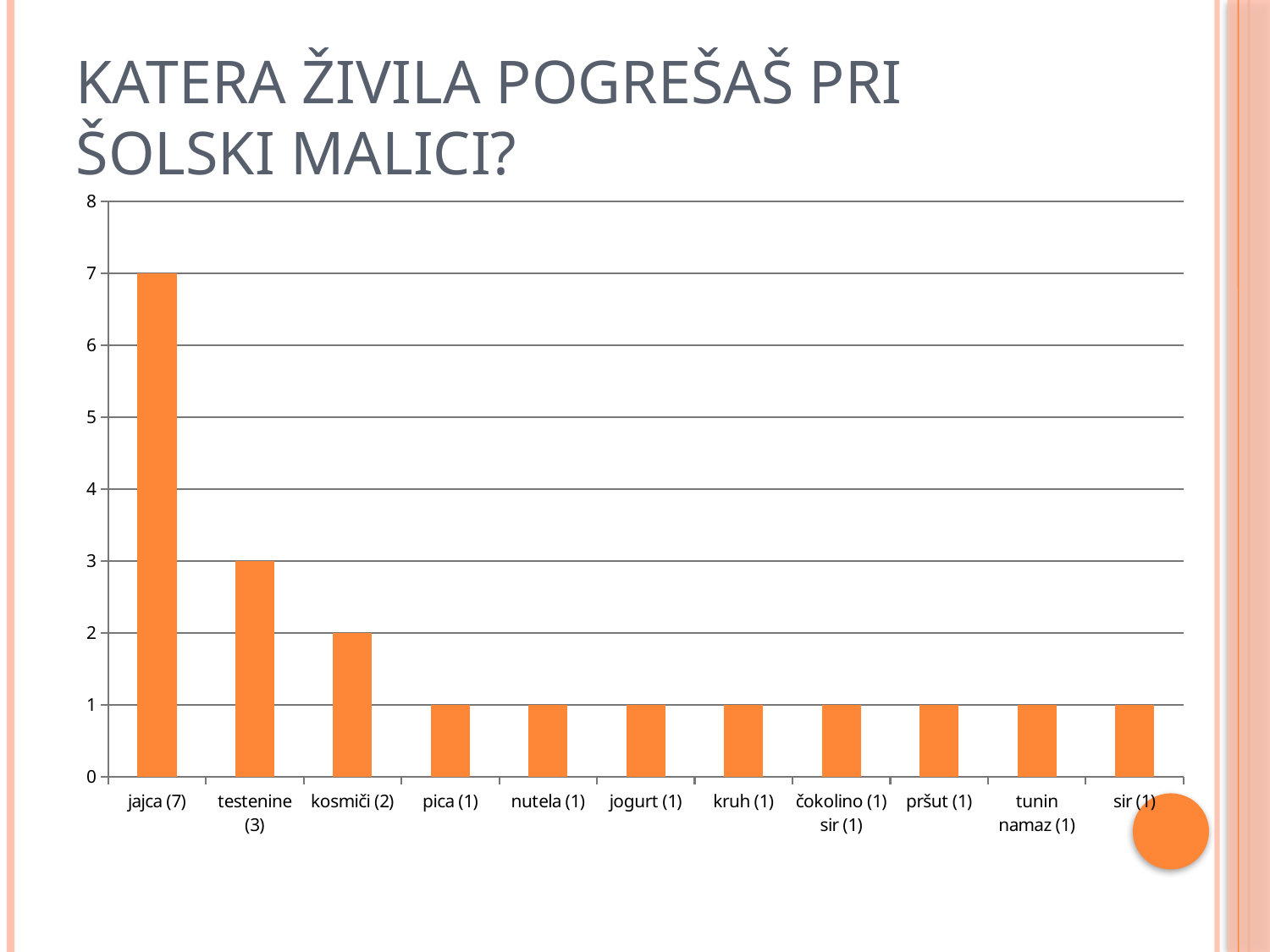
What is the difference between the values for jajca and testenine? 4 What is the value for kosmiči? 2 Which is larger, the value for kosmiči or the value for pica? kosmiči How many categories are shown on the x axis? 11 Which category has the highest value? jajca What is the difference between the values for testenine and kosmiči? 1 Is the value for jajca greater or less than 5? greater Do the values rise or fall from left to right along the x axis? fall What kind of chart is shown on the slide? bar chart What is the value for jajca? 7 What is the value for testenine? 3 What is the value for tunin namaz? 1